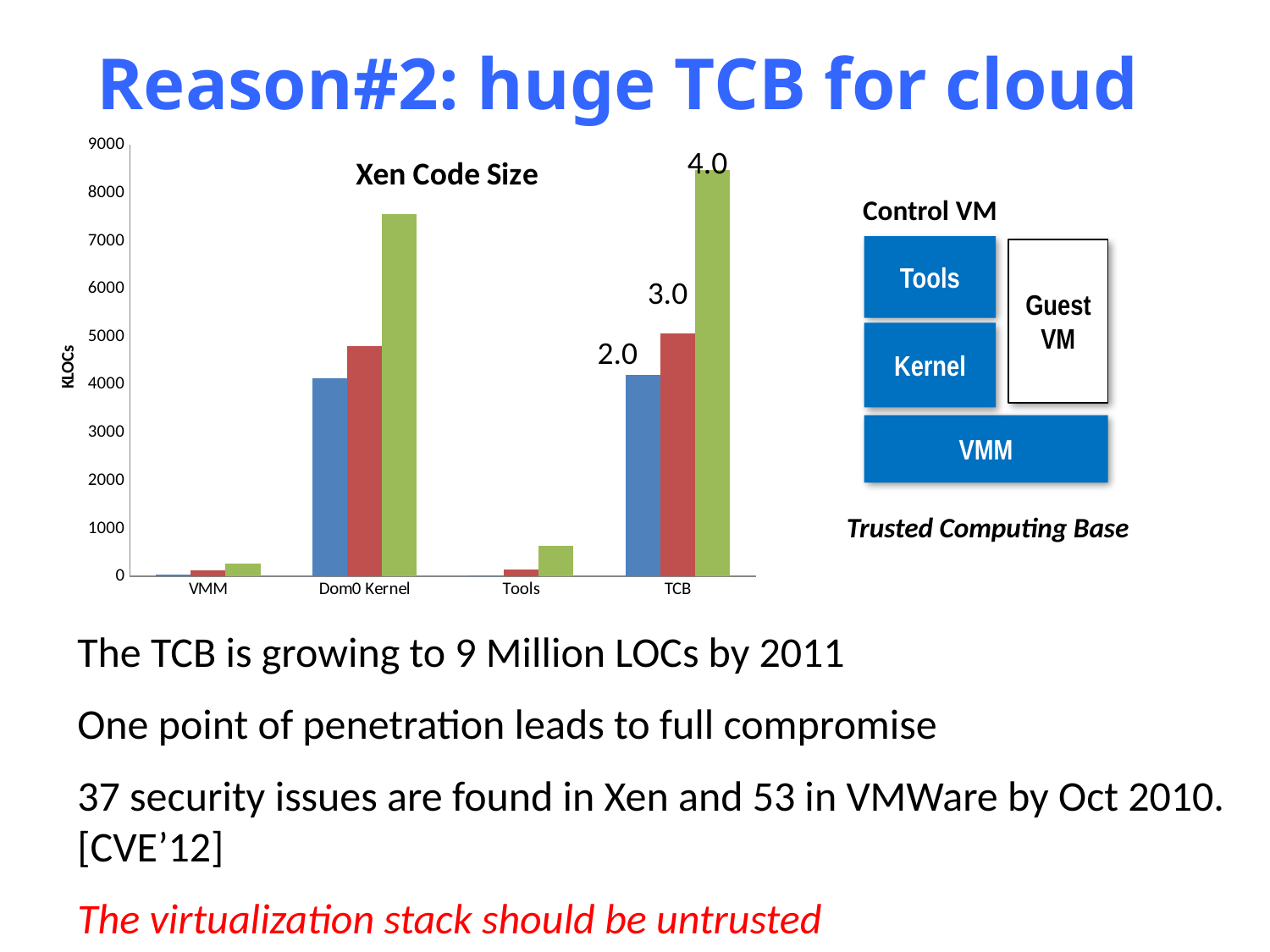
Is the value of the green bar for Dom0 Kernel greater or less than 7000? greater How many categories are shown on the x axis of the chart? 4 What is the label on the vertical axis of the chart? KLOCs Which category has the tallest bar in the chart? TCB Which is larger, the green bar for Dom0 Kernel or the green bar for Tools? Dom0 Kernel Is the value of the green bar for TCB greater or less than 8000? greater Is the value of the blue bar for Dom0 Kernel greater or less than 3000? greater How many bars are plotted for each category in the chart? 3 What kind of chart is shown on the slide? bar chart What is the title of the chart? Xen Code Size